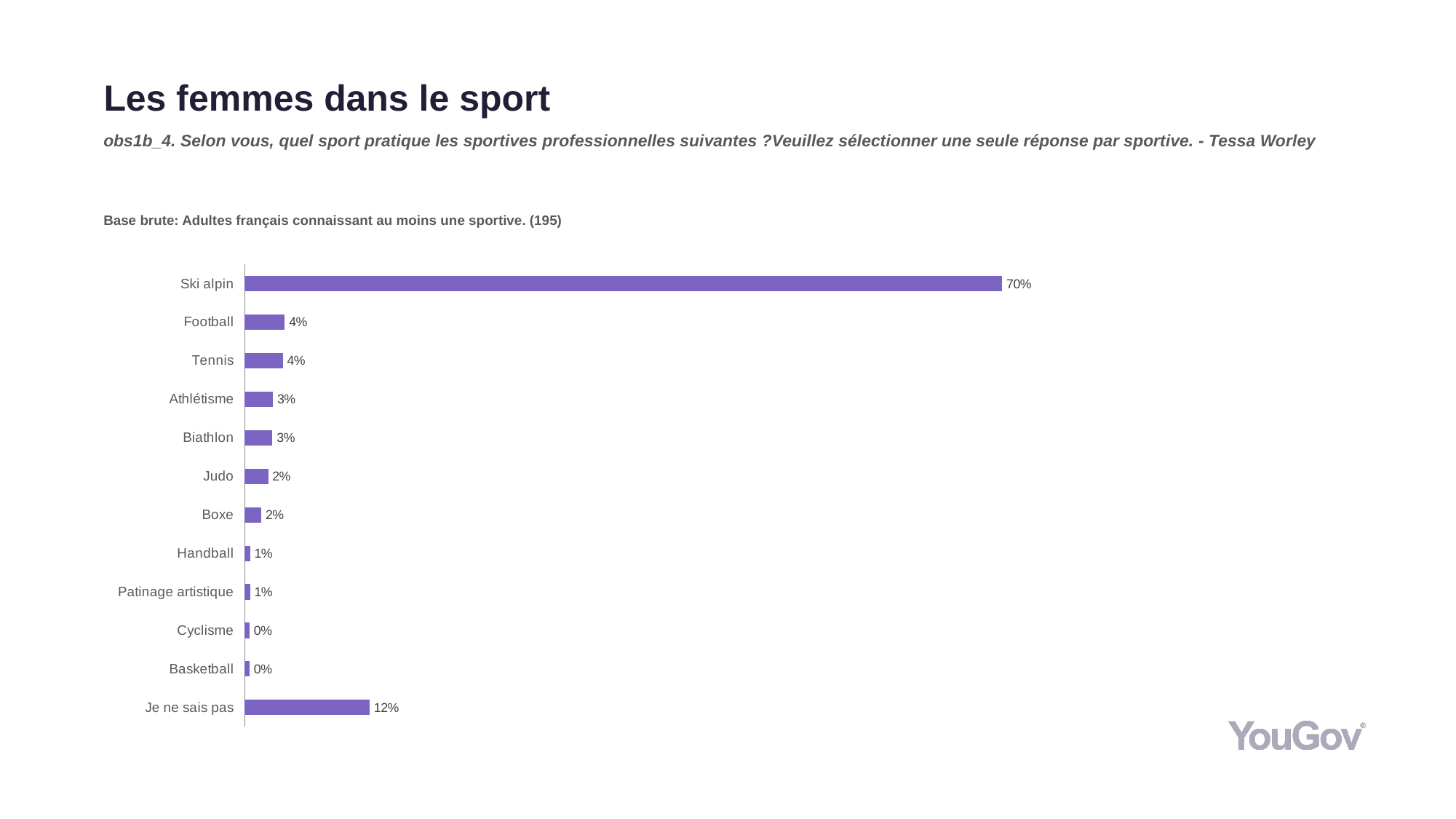
Which is larger, the value for Athlétisme or the value for Handball? Athlétisme What is the value for Ski alpin? 70% What is the value for Boxe? 2% What is the difference between the values for Football and Judo? 2 percentage points What is the difference between the values for Ski alpin and Je ne sais pas? 58 percentage points How many categories are shown in the chart? 12 What is the value for Biathlon? 3% What kind of chart is shown on the slide? Bar chart What is the value for Je ne sais pas? 12% Which category has the highest value? Ski alpin What is the base size stated for the chart? 195 Which is larger, the value for Je ne sais pas or the value for Tennis? Je ne sais pas